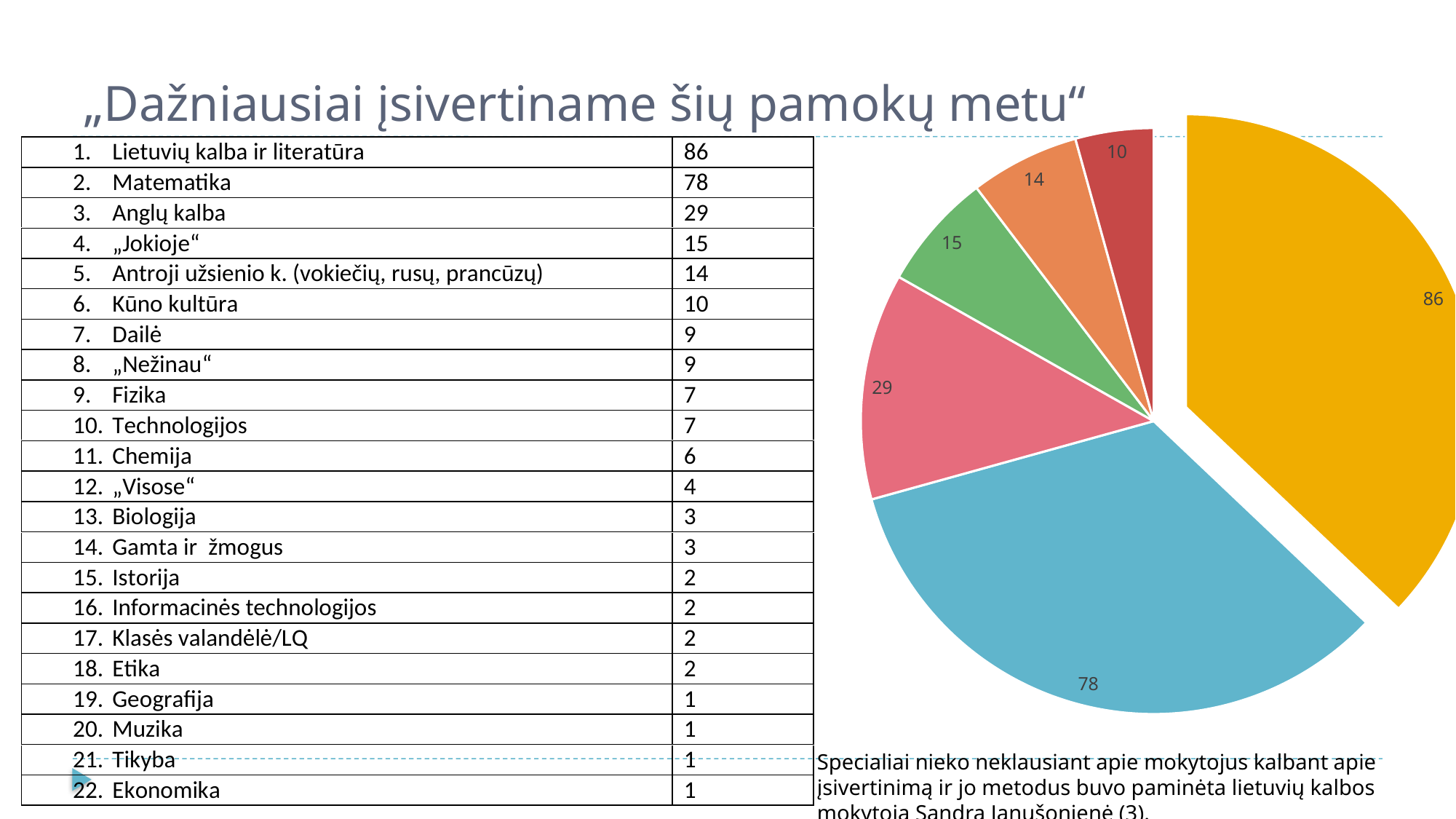
What kind of chart is shown on the slide? pie chart How many slices does the pie chart have? 6 What value is labelled on the green slice of the pie chart? 15 Which slice is larger in the pie chart, the one labelled 29 or the one labelled 15? 29 Which slice of the pie chart is pulled out (exploded) from the rest? the yellow slice labelled 86 What value is labelled on the largest slice of the pie chart? 86 What is the sum of all the slice values shown in the pie chart? 232 What value is labelled on the pink slice of the pie chart? 29 What value is labelled on the blue slice of the pie chart? 78 What is the difference between the two largest slice values in the pie chart (86 and 78)? 8 What value is labelled on the smallest slice of the pie chart? 10 What colour is the slice labelled 14 in the pie chart? orange